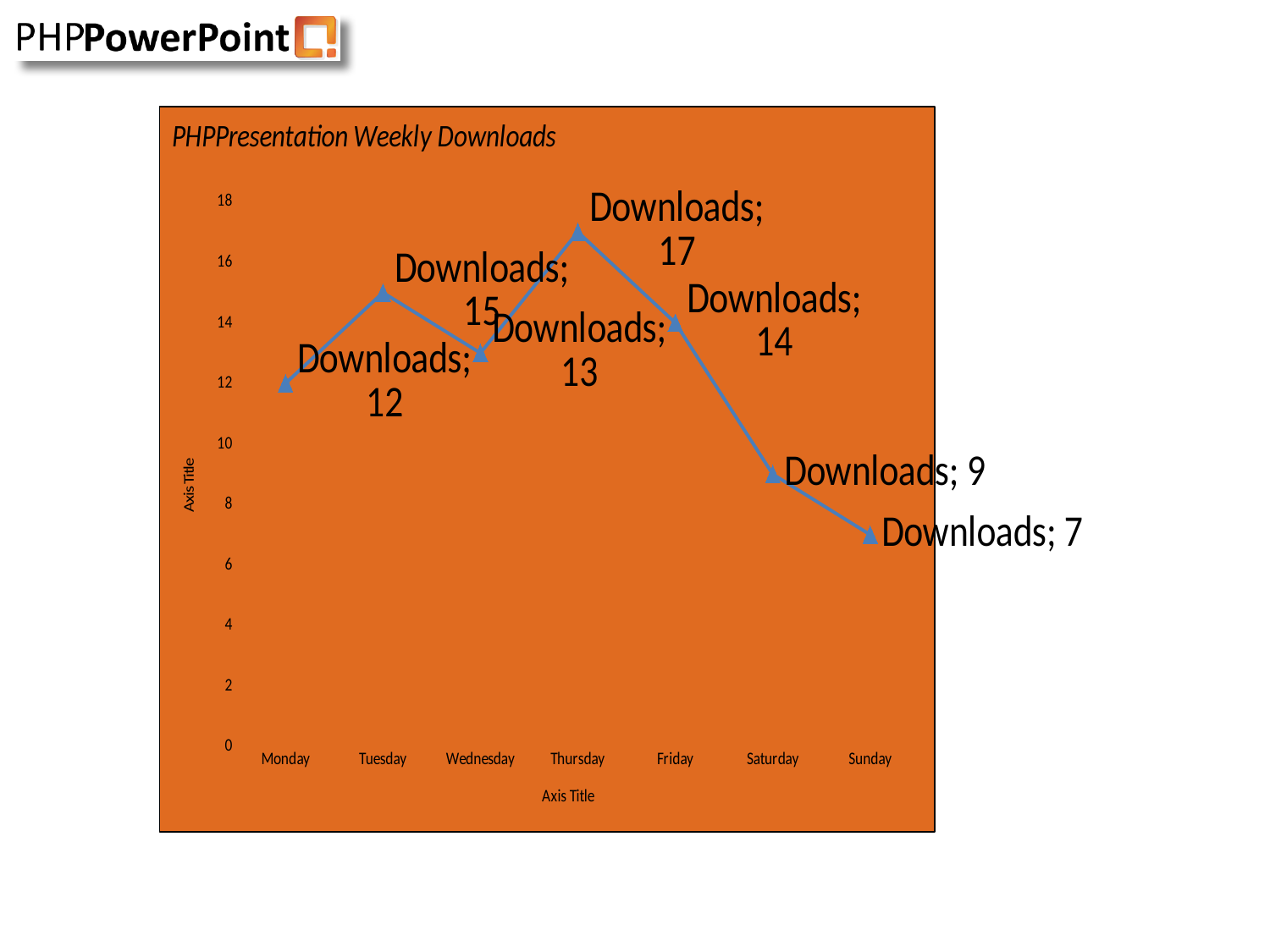
What is the value for Thursday? 17 What kind of chart is shown? line chart Is the value for Saturday greater or less than 10? less What is the value for Sunday? 7 Do the values rise or fall from Thursday to Sunday? fall Which is larger, the value for Tuesday or the value for Friday? Tuesday What is the difference between the values for Thursday and Sunday? 10 Which day has the lowest number of downloads? Sunday What is the title of the chart? PHPPresentation Weekly Downloads How many days are plotted on the x axis? 7 Which day has the highest number of downloads? Thursday What is the value for Monday? 12